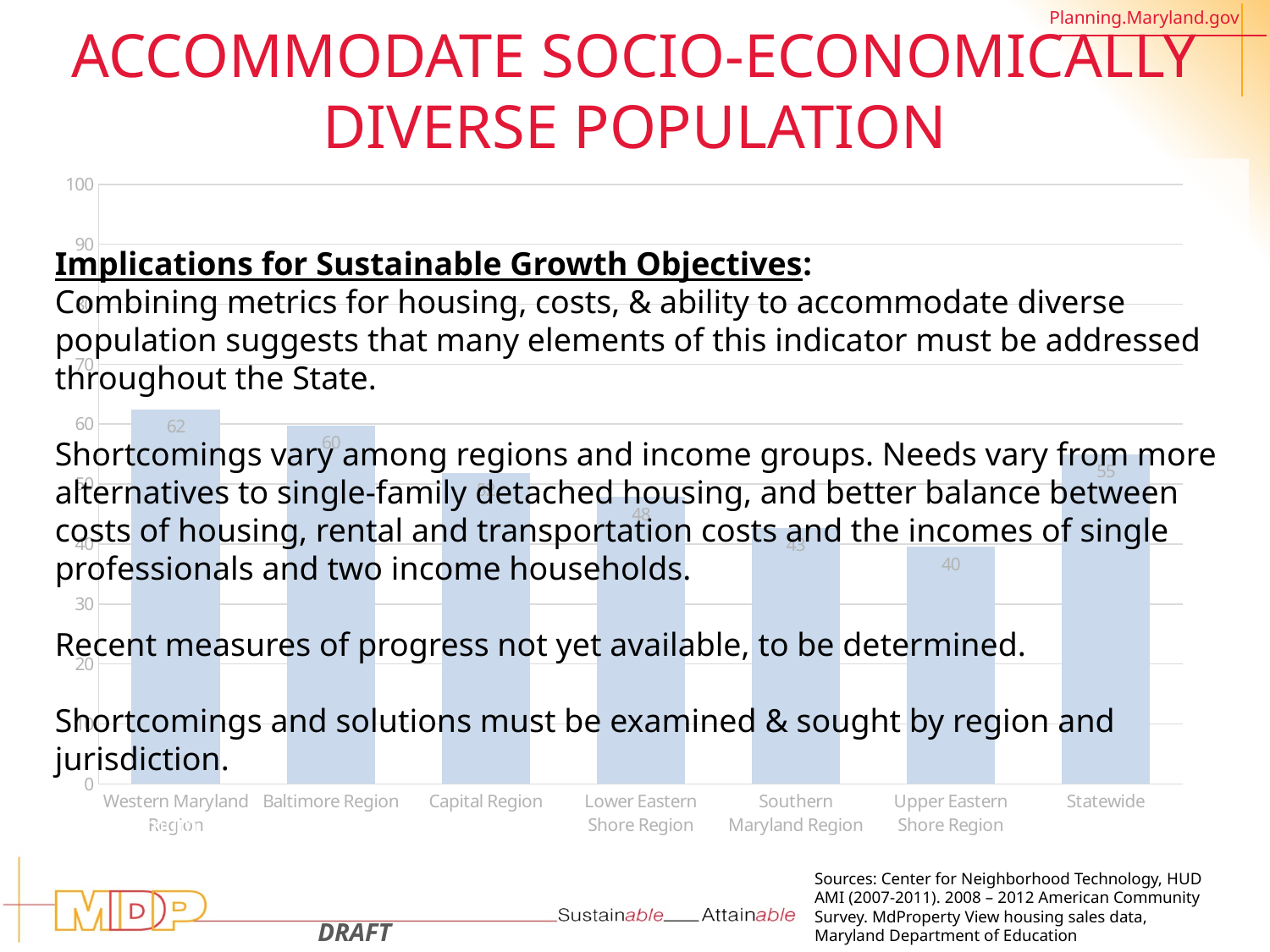
Is the value for Capital Region greater or less than 40? greater What is the value for Statewide? 55 What is the difference between the values for Western Maryland Region and Upper Eastern Shore Region? 22 Which region has the highest value in the chart? Western Maryland Region Which region has the lowest value in the chart? Upper Eastern Shore Region What kind of chart is shown on the slide? bar chart Which is larger, the value for Statewide or the value for Southern Maryland Region? Statewide What is the value for Western Maryland Region? 62 What is the value for Baltimore Region? 60 What is the value for Upper Eastern Shore Region? 40 What is the value for Lower Eastern Shore Region? 48 How many regions (categories) are shown on the x axis of the chart? 7